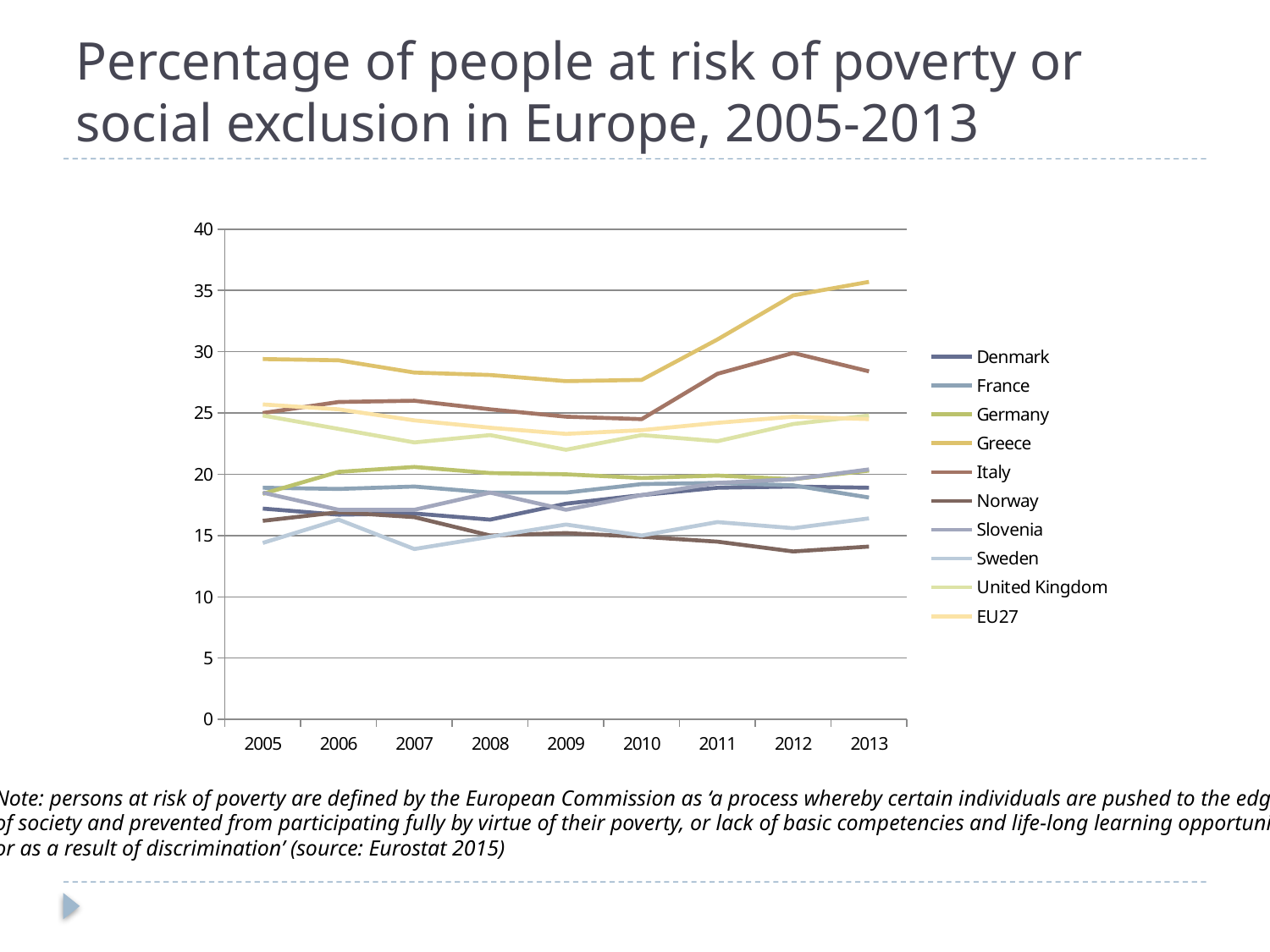
Which country has the highest value in 2013? Greece Which series has the lowest value in 2005? Sweden Is the value for Norway in 2013 greater or less than 15? less Does the value for Greece rise or fall from 2010 to 2013? rise Is the value for Italy in 2012 greater or less than 25? greater How many series does the legend list? 10 Which country has the lowest value in 2013? Norway Is the value for Greece in 2013 greater or less than 30? greater What is the title of the chart on the slide? Percentage of people at risk of poverty or social exclusion in Europe, 2005-2013 What kind of chart is shown on the slide? line chart Which is larger in 2013, the value for Greece or the value for Italy? Greece How many years are shown on the x axis? 9